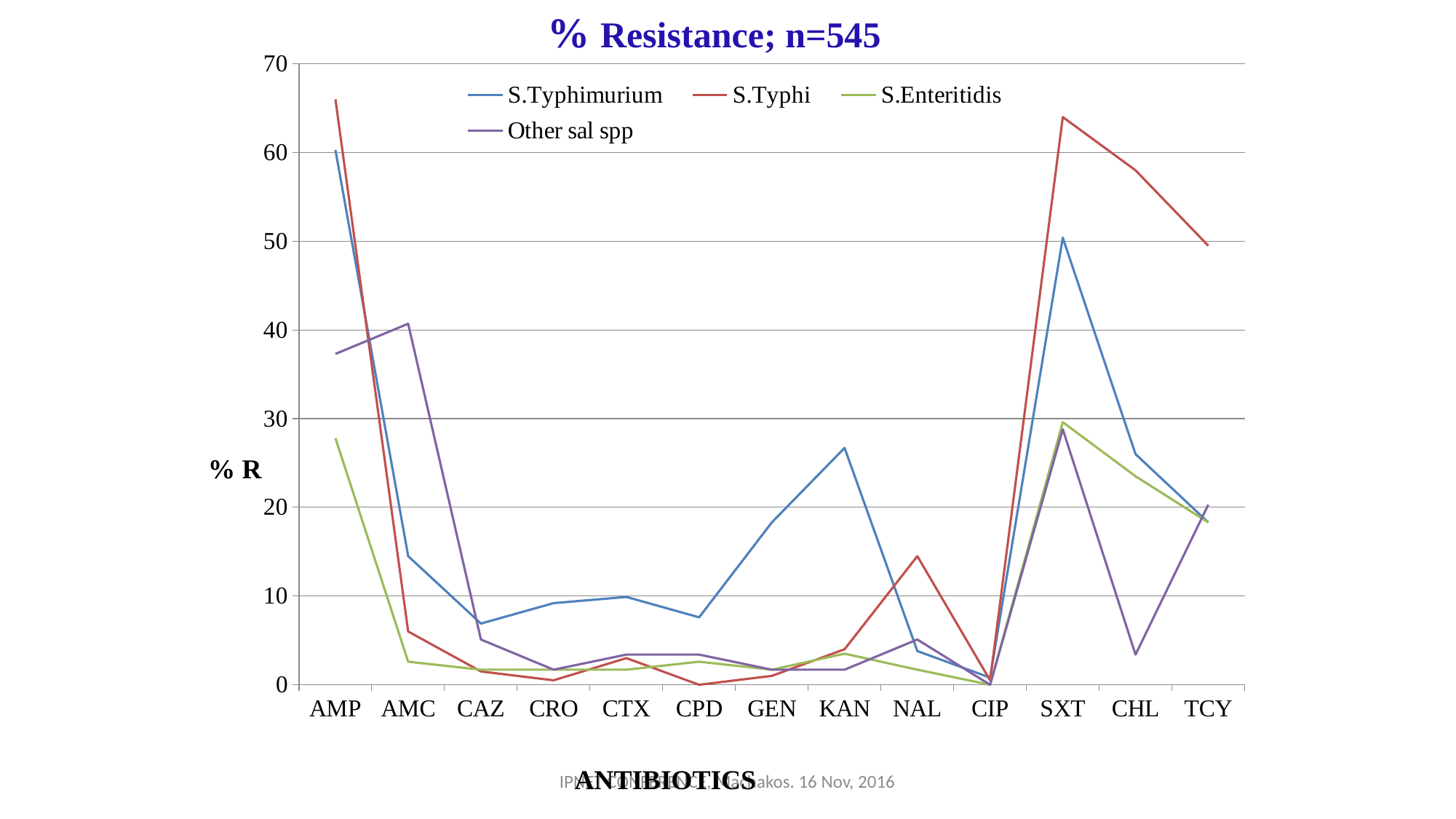
Is the value for S.Typhi at AMP greater or less than 60? greater What is the title of the chart? % Resistance; n=545 At SXT, which series has the larger value, S.Typhi or S.Typhimurium? S.Typhi Is the value for S.Typhimurium at KAN greater or less than 20? greater Is the value for S.Enteritidis at AMP greater or less than 30? less How many series does the legend list? 4 How many antibiotics are shown along the x axis? 13 For which antibiotic is the S.Typhimurium resistance highest? AMP Does the S.Typhi line rise or fall from SXT to TCY? fall At AMC, which series has the larger value, Other sal spp or S.Typhimurium? Other sal spp What kind of chart is shown on the slide? line chart